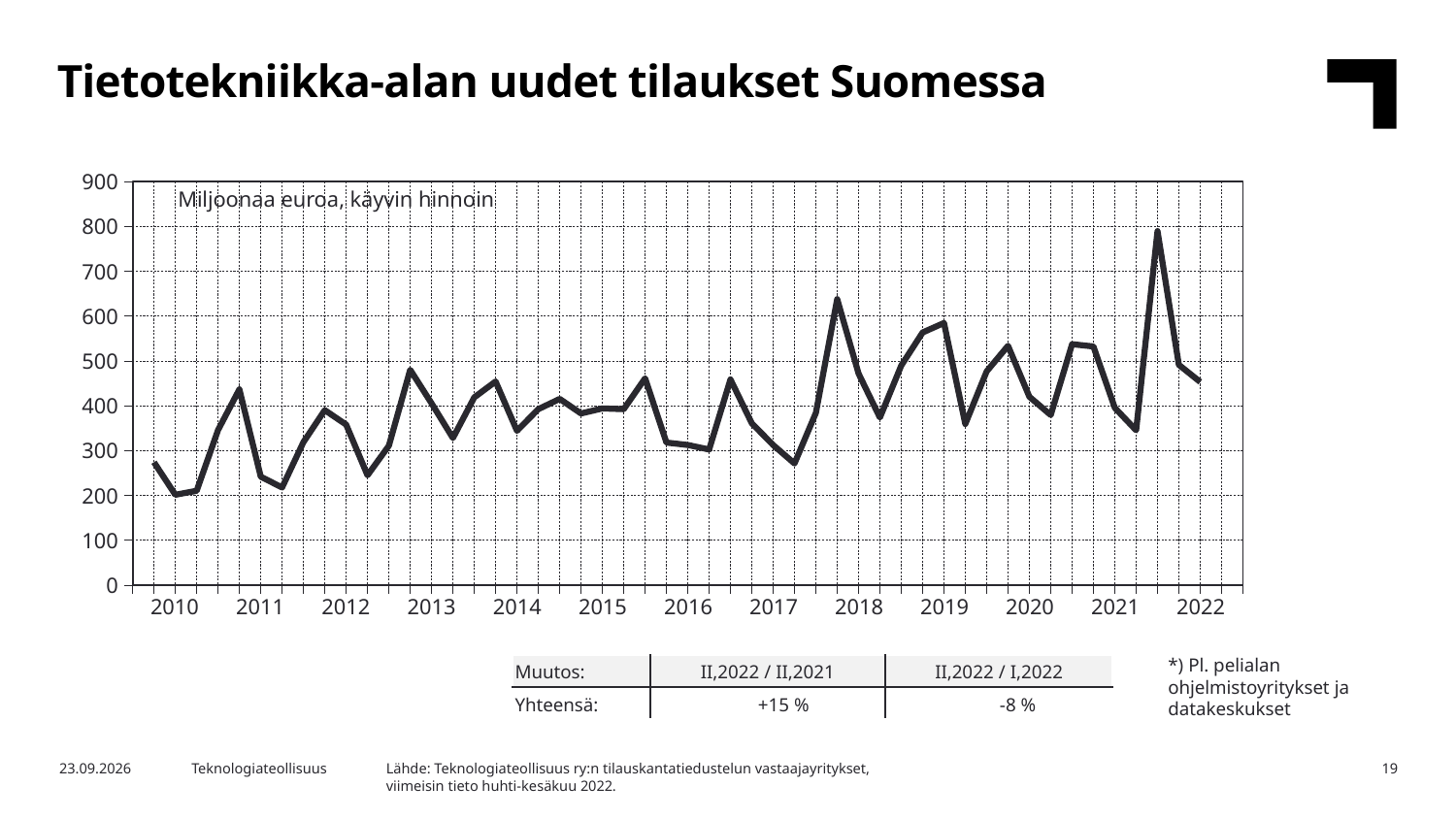
How many year labels are shown on the x axis? 13 What kind of chart is shown on the slide? line chart According to the table below the chart, what is the change for II,2022 / II,2021? +15 % Is the highest peak of the line, in 2021, greater or less than 700? greater What unit label is printed inside the chart area? Miljoonaa euroa, käyvin hinnoin Is the lowest point of the line, in 2010, greater or less than 300? less What is the title of the slide's chart? Tietotekniikka-alan uudet tilaukset Suomessa Is the peak of the line in 2018 greater or less than 500? greater In which year does the line reach its highest point? 2021 What is the highest value shown on the y axis? 900